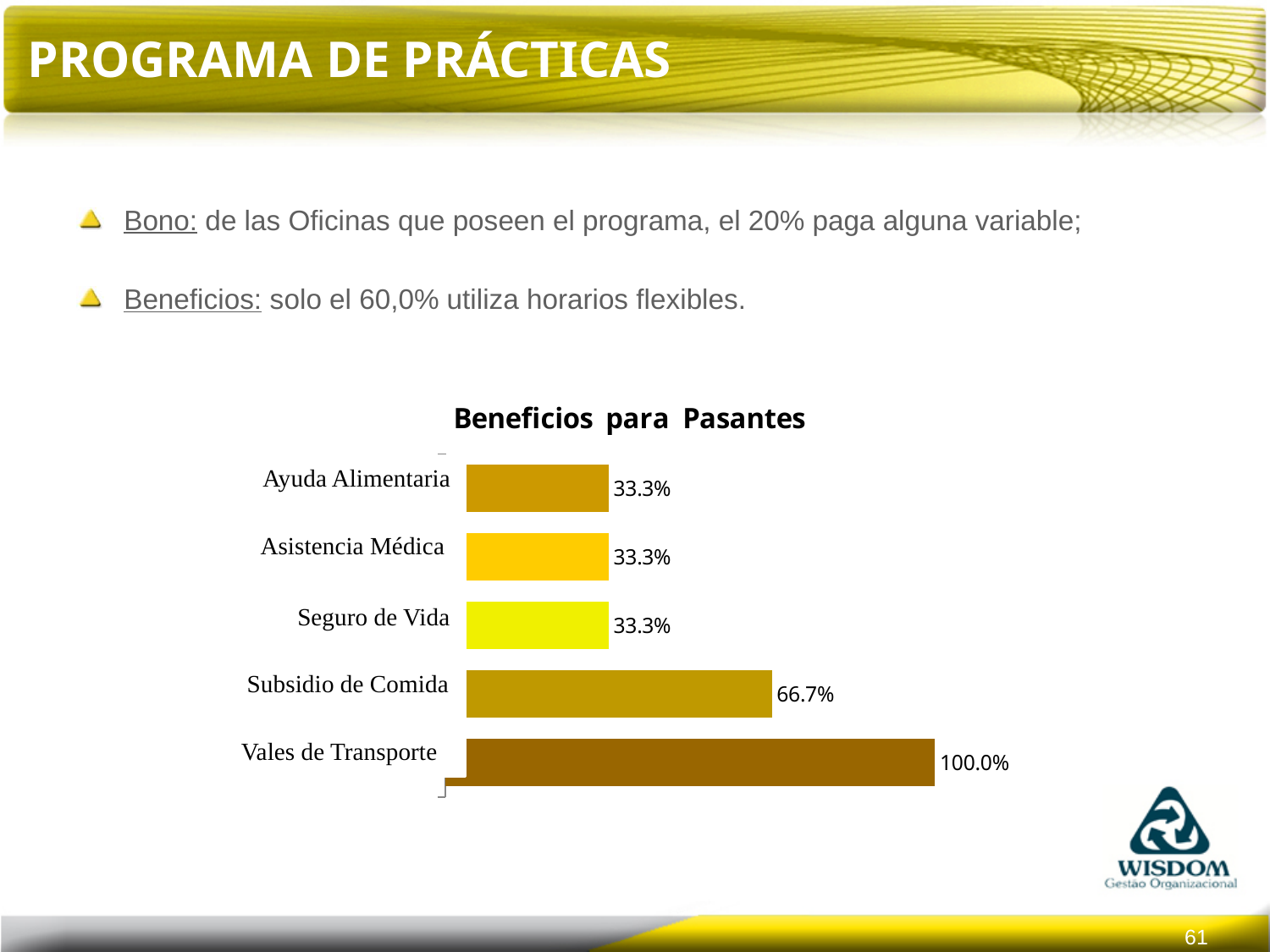
How many categories have a value of 33.3%? 3 Which is larger, the value for Subsidio de Comida or the value for Asistencia Médica? Subsidio de Comida Which category has the highest value? Vales de Transporte What is the value for Seguro de Vida? 33.3% What kind of chart is shown on the slide? Bar chart What is the title of the chart? Beneficios para Pasantes What is the difference between the values for Vales de Transporte and Subsidio de Comida? 33.3% How many categories are shown in the chart? 5 What is the value for Subsidio de Comida? 66.7% What is the difference between the values for Subsidio de Comida and Ayuda Alimentaria? 33.4% What is the value for Vales de Transporte? 100.0% Which category is listed at the bottom of the chart? Vales de Transporte